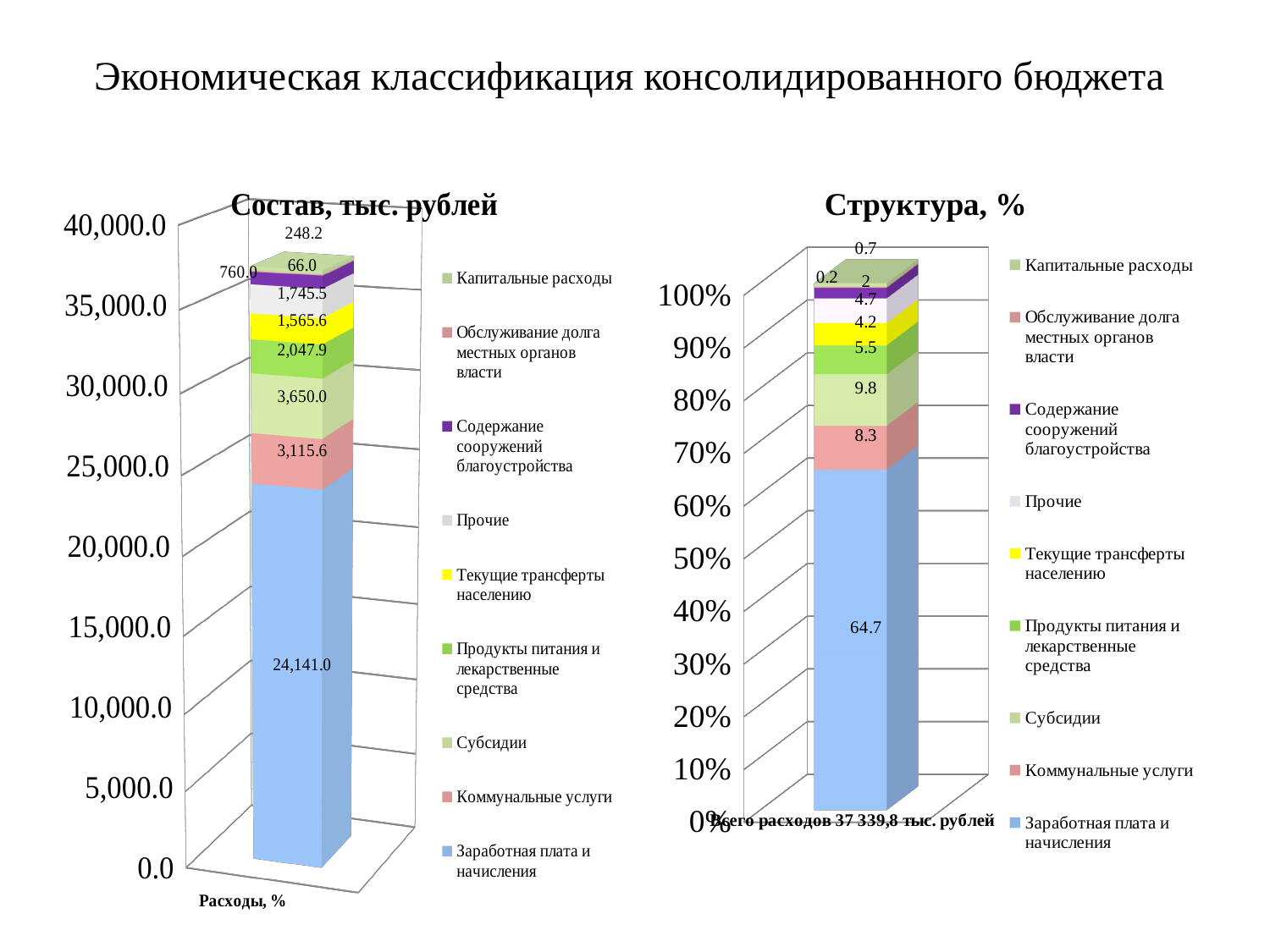
In the chart titled "Структура, %", which series has the largest value? Заработная плата и начисления In the chart titled "Состав, тыс. рублей", what is the difference between Субсидии and Коммунальные услуги? 534.4 How many series does the legend of the chart titled "Структура, %" list? 9 In the chart titled "Структура, %", what is the value for Коммунальные услуги? 8.3 In the chart titled "Состав, тыс. рублей", what is the total of the stacked bar? 37,339.8 In the chart titled "Состав, тыс. рублей", what is the value for Субсидии? 3,650.0 In the chart titled "Структура, %", which is larger: Прочие or Текущие трансферты населению? Прочие In the chart titled "Состав, тыс. рублей", what is the value for Заработная плата и начисления? 24,141.0 In the chart titled "Состав, тыс. рублей", what is the value for Содержание сооружений благоустройства? 760.0 In the chart titled "Состав, тыс. рублей", which series has the smallest value? Обслуживание долга местных органов власти In the chart titled "Структура, %", what is the value for Продукты питания и лекарственные средства? 5.5 What kind of chart is the chart titled "Состав, тыс. рублей"? Stacked bar chart